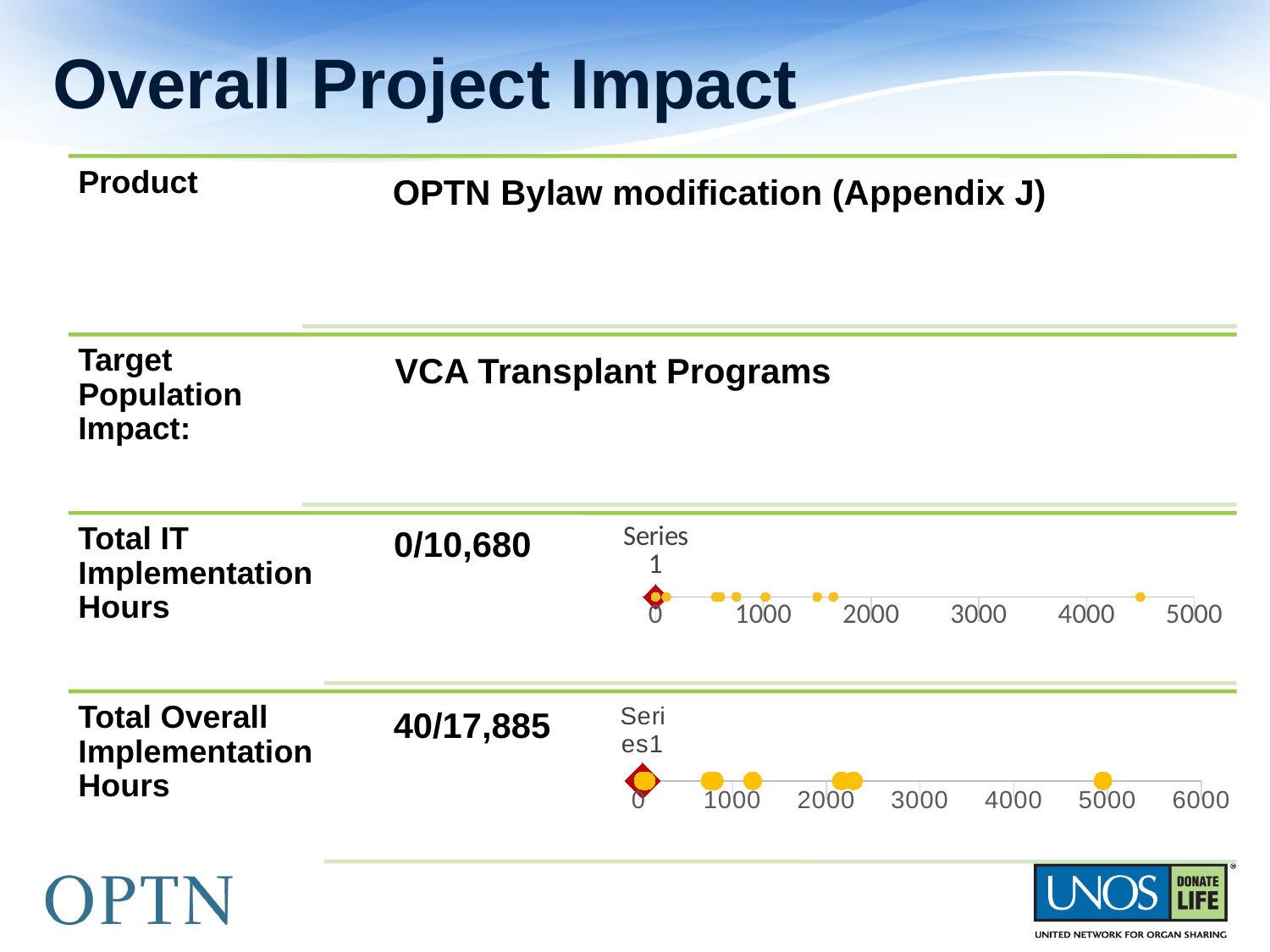
In the chart next to 'Total IT Implementation Hours', is the leftmost cluster of points greater or less than 1000? less In the chart next to 'Total IT Implementation Hours', what is the largest value labelled on the horizontal axis? 5000 In the chart next to 'Total IT Implementation Hours', is the rightmost point greater or less than 5000? less In the chart next to 'Total IT Implementation Hours', is the rightmost point greater or less than 4000? greater In the chart next to 'Total Overall Implementation Hours', at what axis value is the red diamond marker located? 0 What kind of chart is shown next to 'Total Overall Implementation Hours'? scatter chart In the chart next to 'Total IT Implementation Hours', at what axis value is the red diamond marker located? 0 In the chart next to 'Total Overall Implementation Hours', what is the largest value labelled on the horizontal axis? 6000